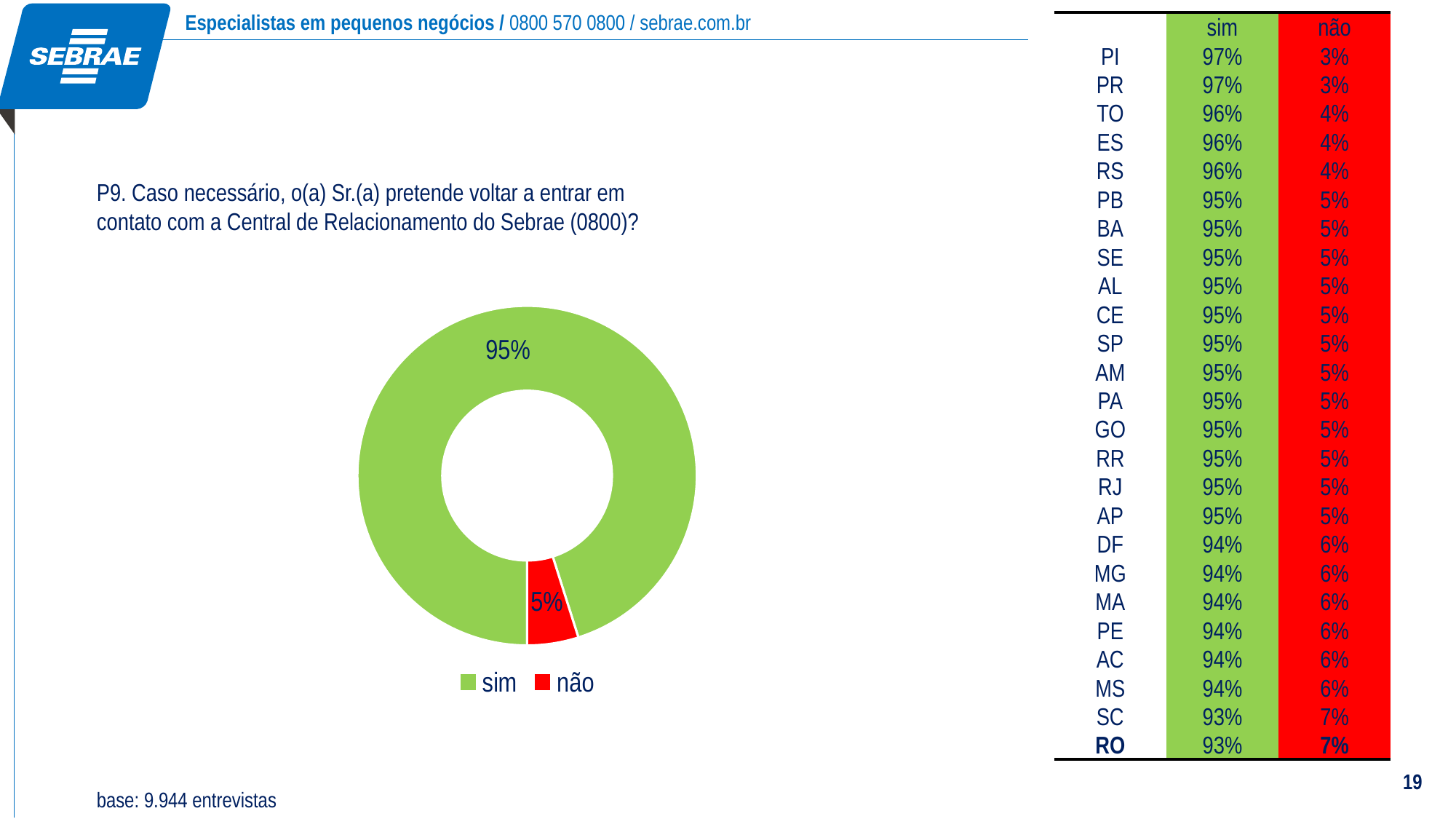
Which is larger in the pie chart, "sim" or "não"? sim What is the value for "sim" in the pie chart? 95% What is the difference between the "sim" and "não" values in the pie chart? 90% How many slices does the pie chart have? 2 What kind of chart is shown on the slide? pie chart (donut) What colour is the "sim" slice in the pie chart? green What share of the pie chart does the "não" slice represent? 5% Which slice of the pie chart is the smallest? não Which slice of the pie chart is the largest? sim How many entries does the legend of the pie chart list? 2 What is the value for "não" in the pie chart? 5% What colour is the "não" slice in the pie chart? red